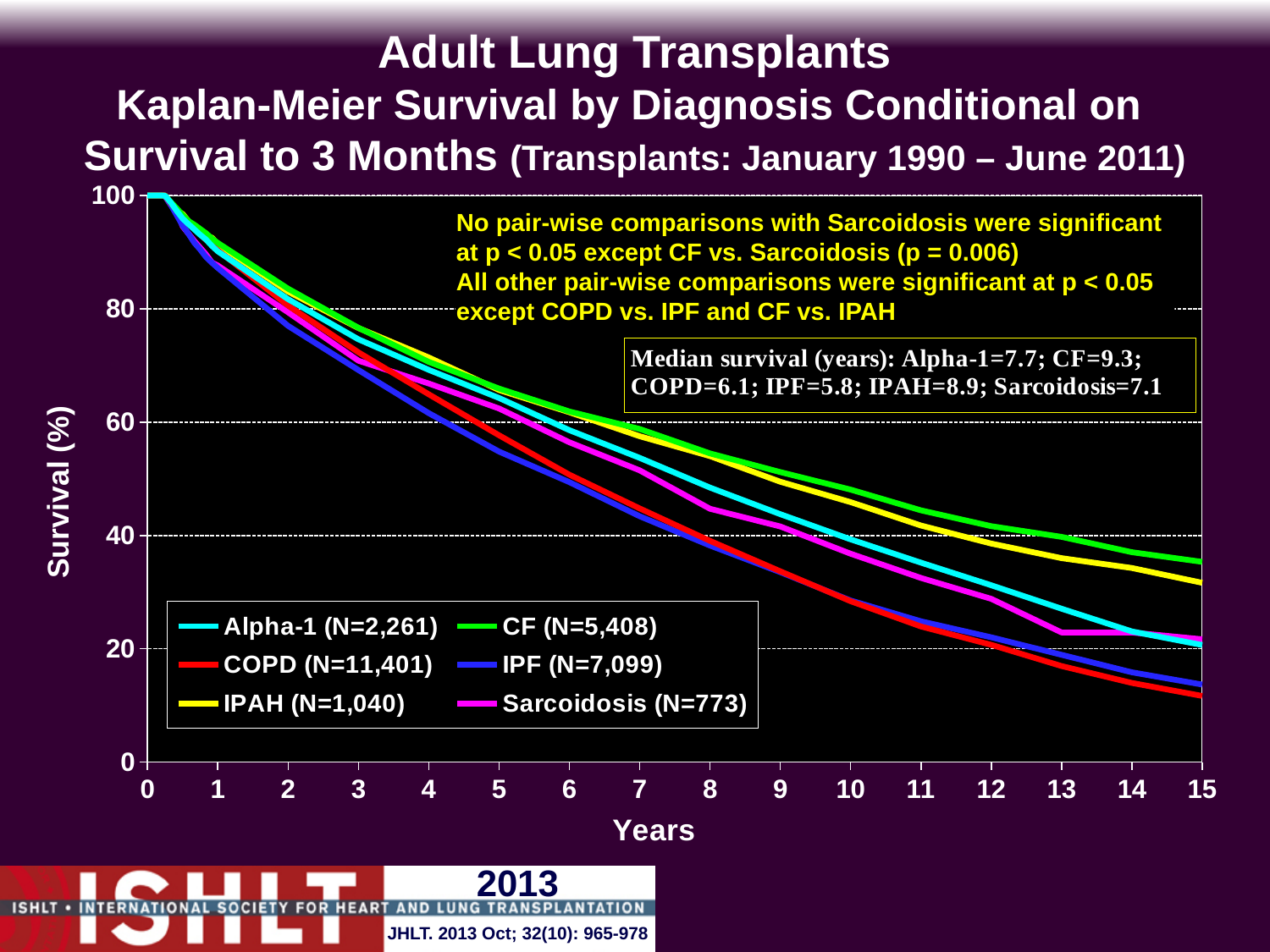
What is the difference in median survival (years) between CF and IPF? 3.5 Is the survival value for COPD at 15 years greater or less than 20? less What is the label of the y-axis? Survival (%) Do the survival curves rise or fall as years increase? Fall Which diagnosis has the lowest median survival according to the text box? IPF How many diagnosis groups (series) does the legend list? 6 What kind of chart is shown on the slide? Line chart According to the text box, what is the median survival in years for CF? 9.3 Is the survival value for CF at 10 years greater or less than 40? greater At 15 years, which curve shows higher survival, CF or COPD? CF What is the N (number of patients) for the COPD group shown in the legend? 11,401 Which diagnosis has the highest median survival according to the text box? CF